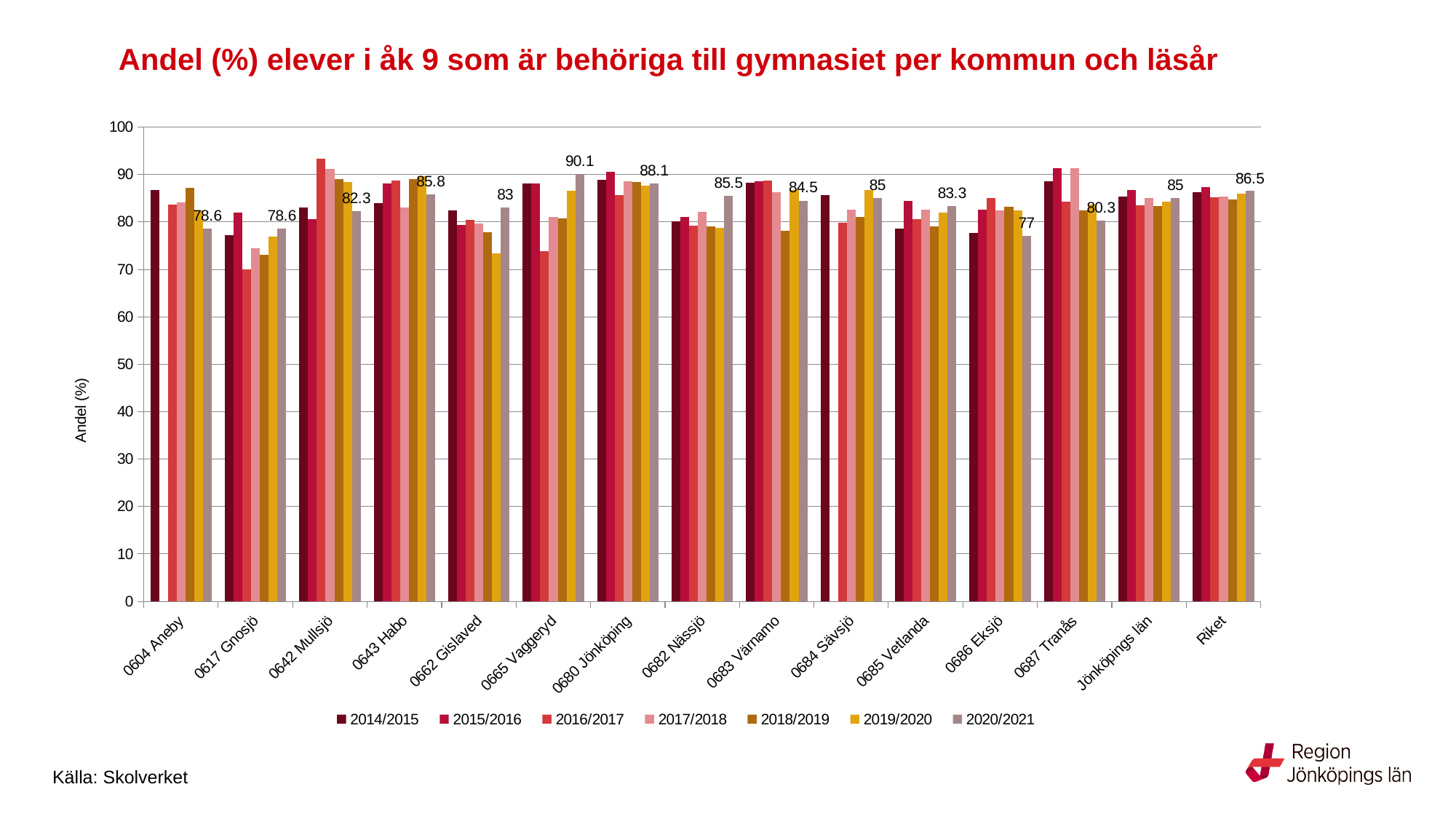
Which category has the lowest value in the 2020/2021 series? 0686 Eksjö What is the value for Riket in the 2020/2021 series? 86.5 How many categories are shown on the x axis? 15 What is the difference between the 2020/2021 values for 0680 Jönköping and 0687 Tranås? 7.8 Is the value for 0617 Gnosjö in the 2016/2017 series greater or less than 80? less In the 2020/2021 series, which is larger: 0682 Nässjö or 0683 Värnamo? 0682 Nässjö Which municipality has the highest value in the 2020/2021 series? 0665 Vaggeryd What is the value for 0643 Habo in the 2020/2021 series? 85.8 How many series does the legend list? 7 What is the value for 0686 Eksjö in the 2020/2021 series? 77 What is the value for 0665 Vaggeryd in the 2020/2021 series? 90.1 What kind of chart is shown on the slide? bar chart